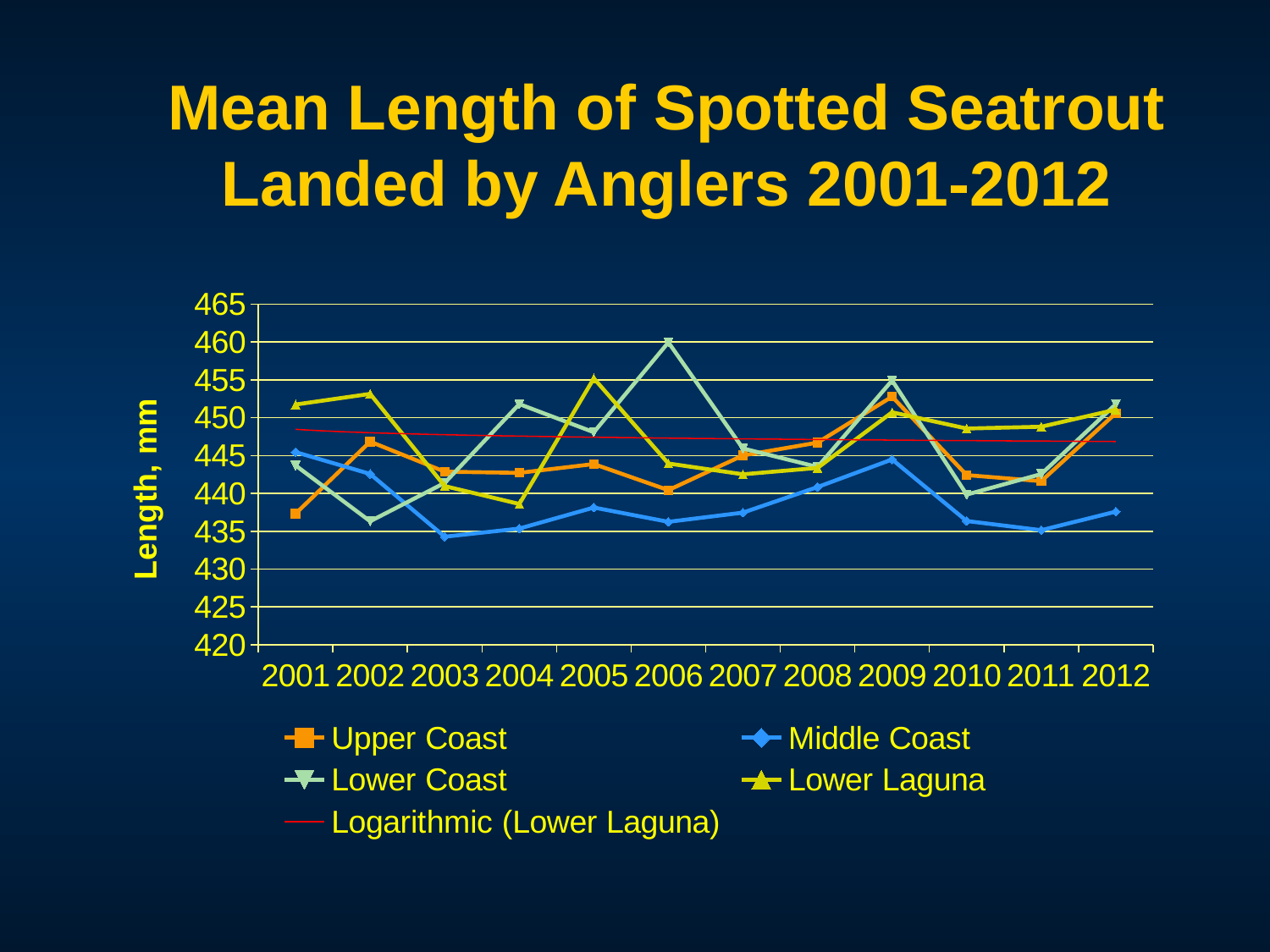
Which series has the highest value in 2001? Lower Laguna Is the value for Lower Coast in 2006 greater or less than 455? greater In 2006, which is larger: Lower Coast or Middle Coast? Lower Coast Is the value for Lower Laguna in 2005 greater or less than 450? greater Is the value for Middle Coast in 2003 greater or less than 440? less How many years are plotted along the x axis? 12 In which year does the Upper Coast series have its lowest value? 2001 How many entries does the legend list? 5 What type of chart is shown on the slide? line chart In which year does the Lower Coast series reach its highest value? 2006 What is the label of the y axis? Length, mm